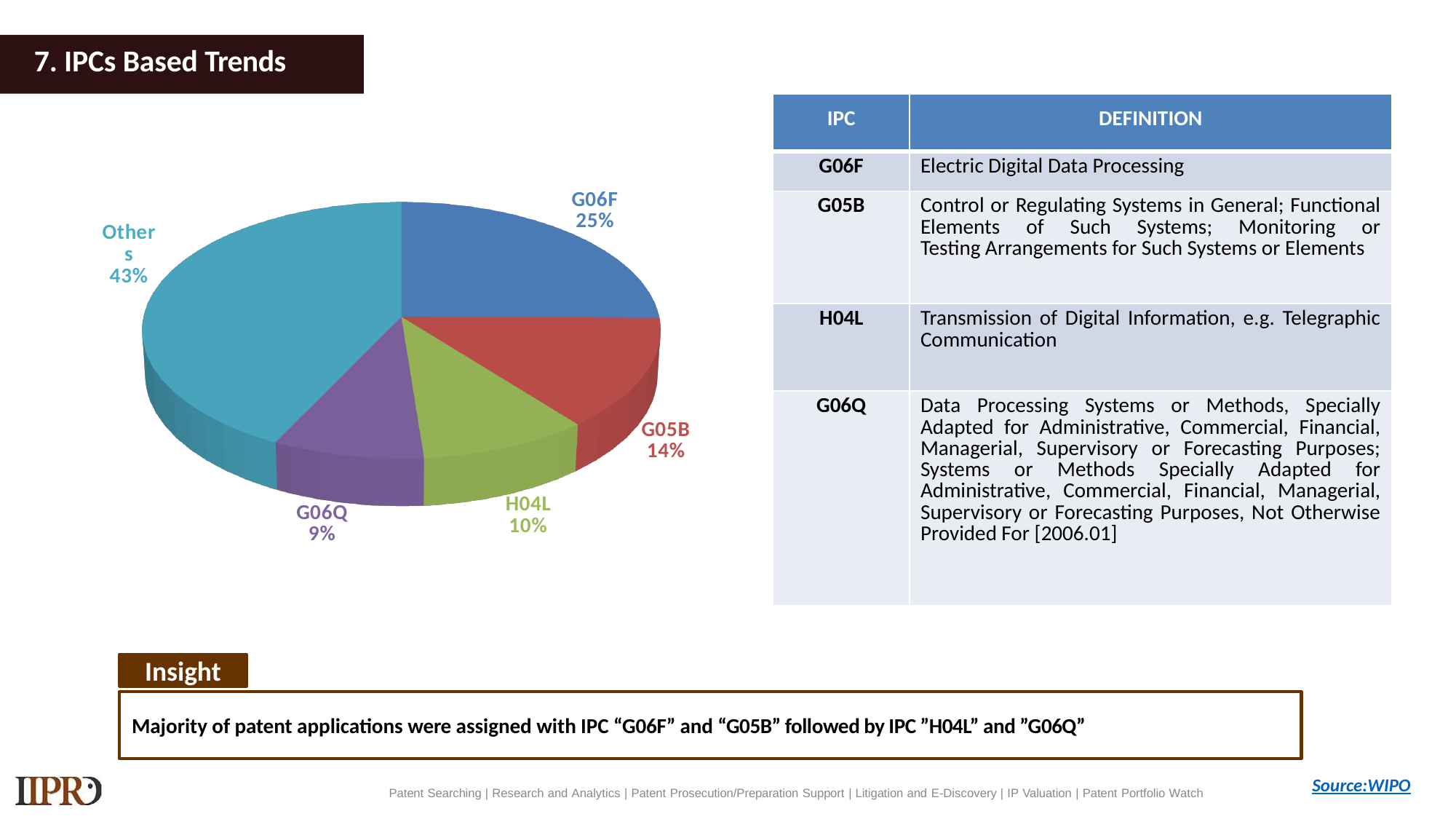
What share of the pie does G06Q have? 9% What share of the pie does H04L have? 10% Which is larger, the share for G06F or the share for H04L? G06F Which slice of the pie is the smallest? G06Q What share of the pie does Others have? 43% What colour is the Others slice of the pie? Teal What is the difference in percentage points between G06F and G05B? 11% How many slices does the pie chart have? 5 What kind of chart is shown on the slide? Pie chart Which slice of the pie is the largest? Others